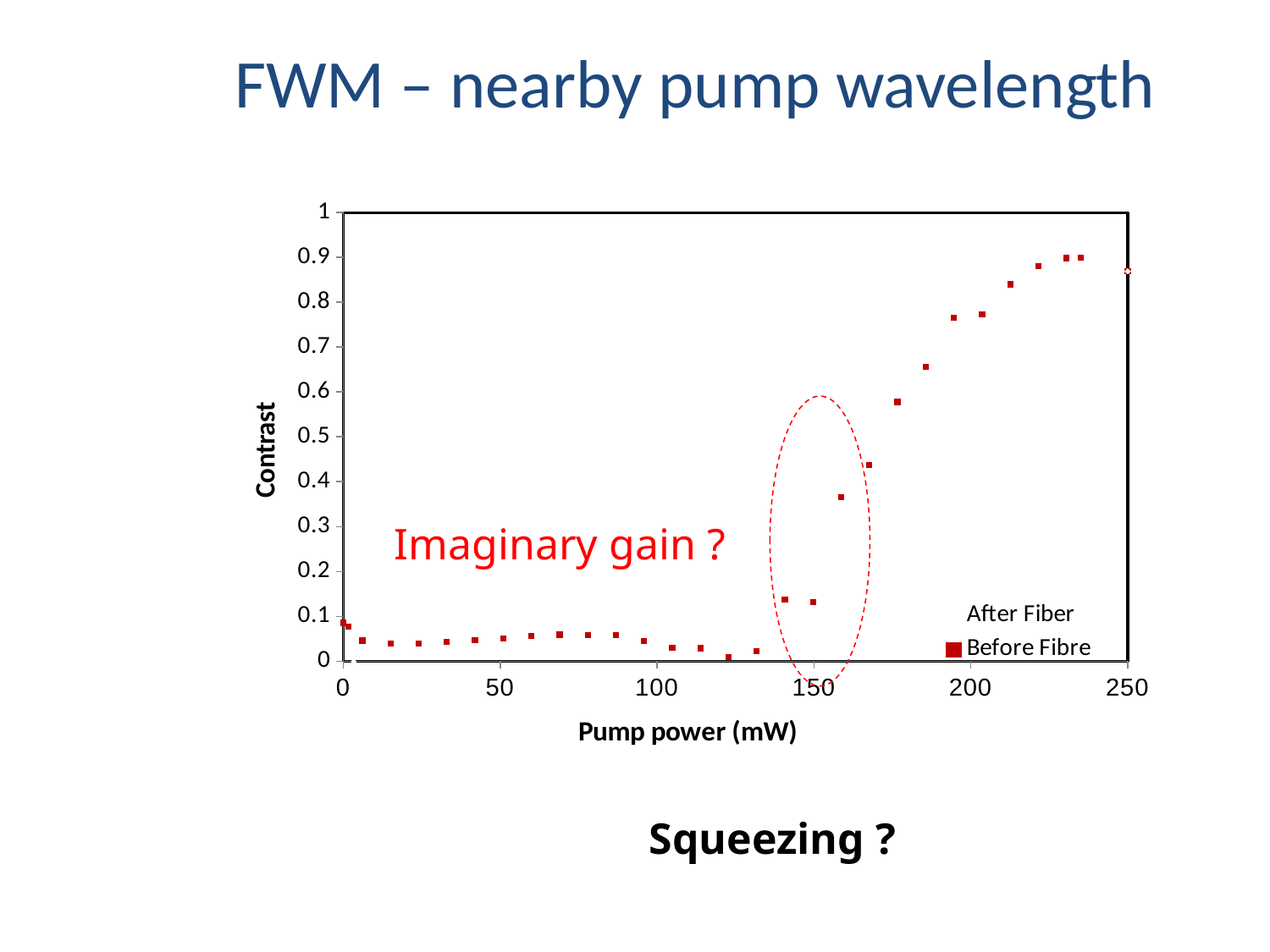
What is the label of the x axis of the chart? Pump power (mW) What is the maximum value shown on the x axis of the chart? 250 Is the contrast value at a pump power of 100 mW greater or less than 0.1? less What kind of chart is shown on the slide? scatter chart Is the contrast value at a pump power of 200 mW greater or less than 0.7? greater Is the contrast value at a pump power of 150 mW greater or less than 0.2? less How many series does the chart legend list? 2 Which has the larger contrast value: the point at 50 mW or the point at 200 mW? 200 mW Between pump powers of 150 mW and 250 mW, does the contrast rise or fall as pump power increases? rise What are the two series named in the chart legend? After Fiber and Before Fibre